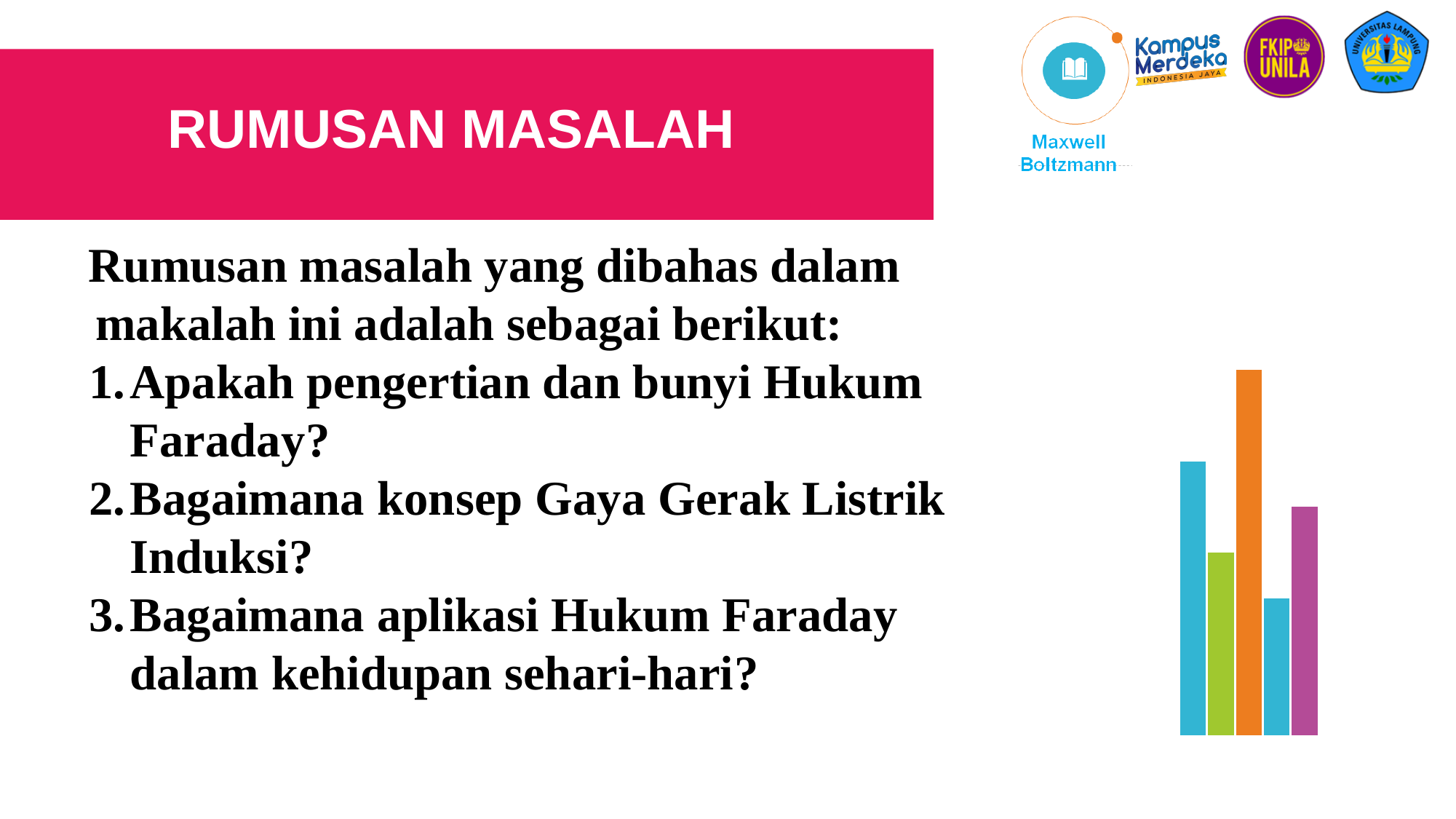
What colour is the tallest bar in the chart on the right? orange In the chart on the right, is the fifth bar from the left taller or shorter than the second bar? taller How many bars does the chart on the right side of the slide have? 5 Which bar in the chart on the right is the tallest, by its position from the left? the third bar In the chart on the right, is the fifth bar from the left taller or shorter than the third bar? shorter What kind of chart is shown on the right side of the slide? bar chart In the chart on the right, is the first bar from the left taller or shorter than the second bar? taller Does the chart on the right side of the slide show any axis labels or data labels? No Which bar in the chart on the right is the shortest, by its position from the left? the fourth bar